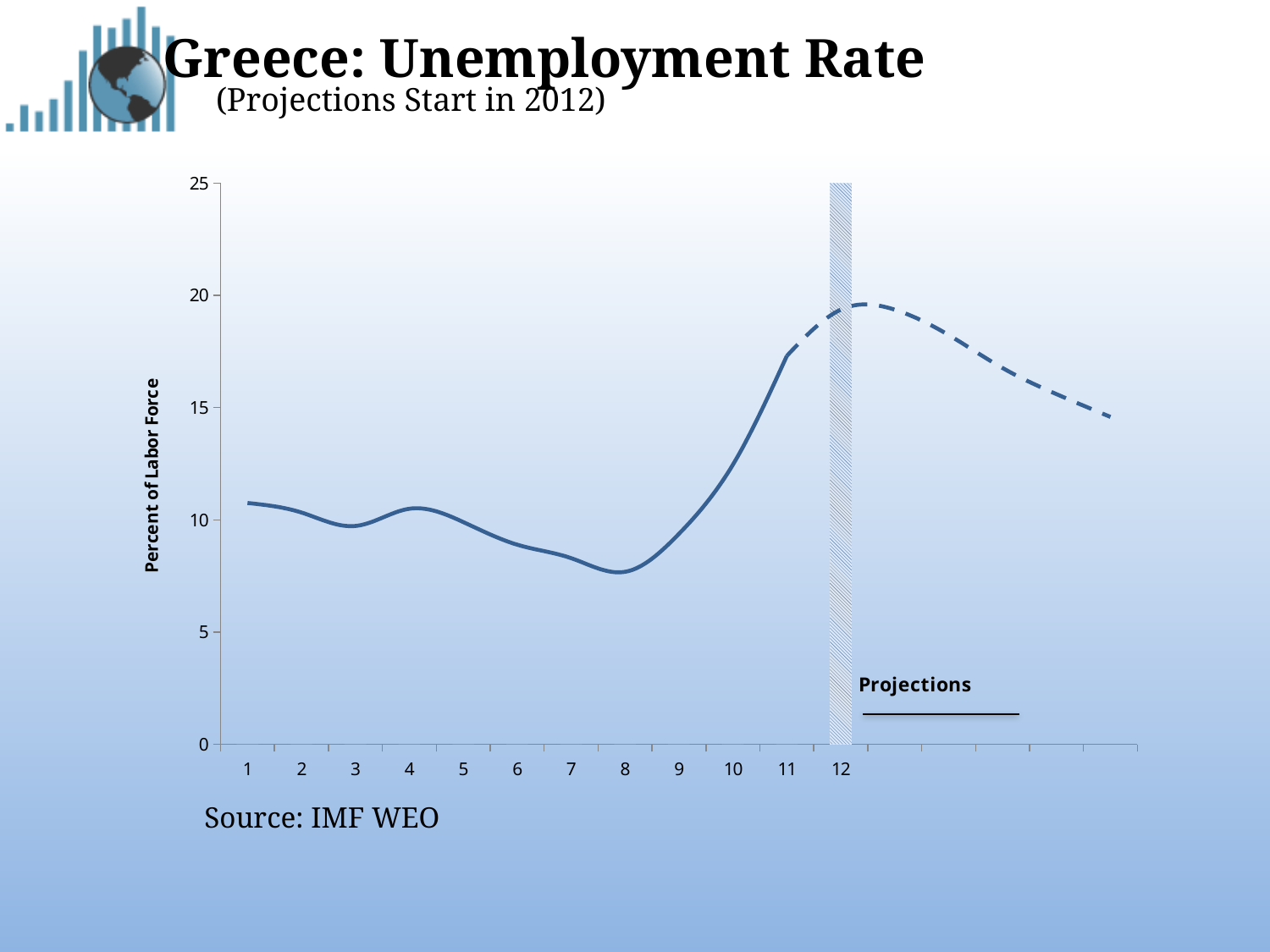
Is the value at point 8 greater or less than 10? less Is the value at point 11 greater or less than 15? greater Is the value at point 6 greater or less than 10? less Which is larger, the value at point 12 or the value at point 8? 12 Among the labeled points 1 to 12, which has the highest value? 12 How many labeled points are there on the x axis? 12 What is the title of the chart? Greece: Unemployment Rate Do the values rise or fall from point 8 to point 12? rise What is the label on the vertical axis? Percent of Labor Force What kind of chart is shown on the slide? line chart Among the labeled points 1 to 12, which has the lowest value? 8